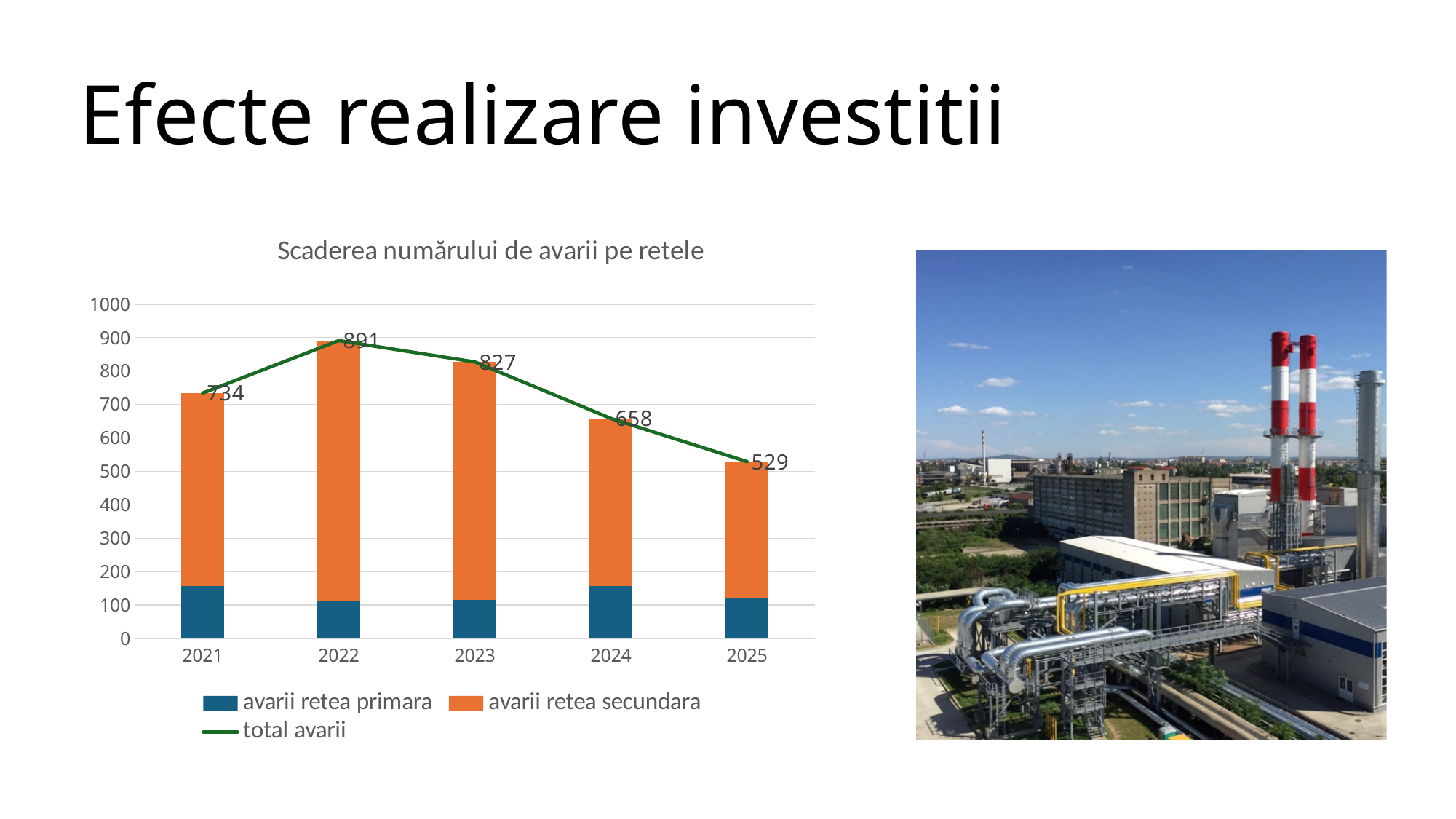
Which year has the highest total avarii? 2022 Which is larger, the total avarii in 2023 or in 2024? 2023 Does the total avarii rise or fall from 2022 to 2025? fall How many years are shown on the x axis? 5 What is the difference between the total avarii in 2022 and in 2021? 157 Which year has the lowest total avarii? 2025 Is the value for avarii retea primara in 2021 greater or less than 100? greater What is the total avarii value for 2021? 734 By how much did the total avarii fall from 2023 to 2024? 169 How many series does the legend list? 3 What is the total avarii value for 2025? 529 What is the total avarii value for 2023? 827